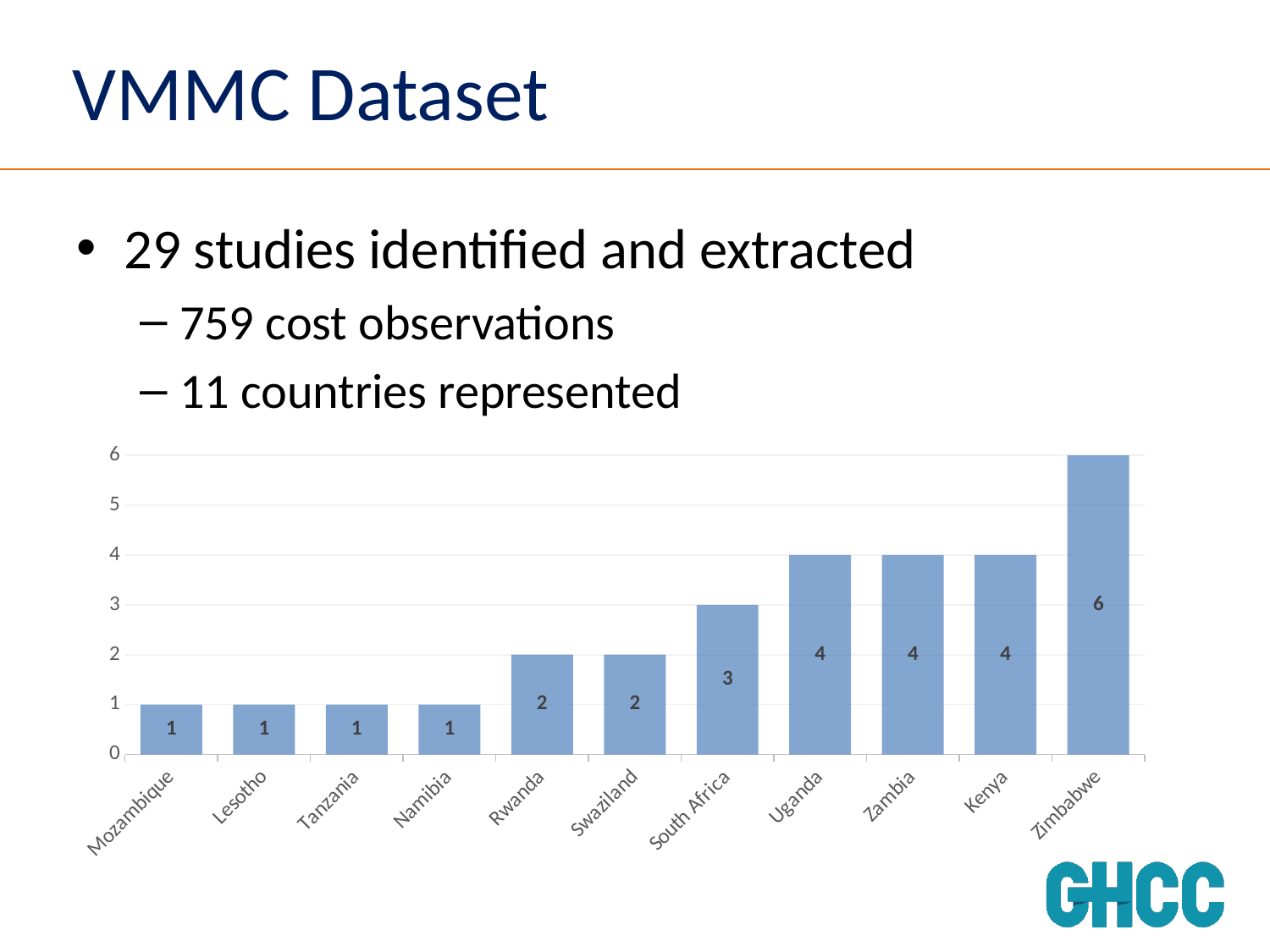
What is the value for Zimbabwe? 6 Do the values rise or fall from left to right along the x axis? rise Which country has the highest value? Zimbabwe How many countries are shown on the x axis? 11 What is the value for Rwanda? 2 What is the difference between the values for Zimbabwe and South Africa? 3 What kind of chart is shown on the slide? bar chart Is the value for Zimbabwe greater or less than 5? greater How many countries have a value of 4? 3 Which is larger, the value for Kenya or the value for Namibia? Kenya What is the difference between the values for Uganda and Swaziland? 2 What is the value for South Africa? 3